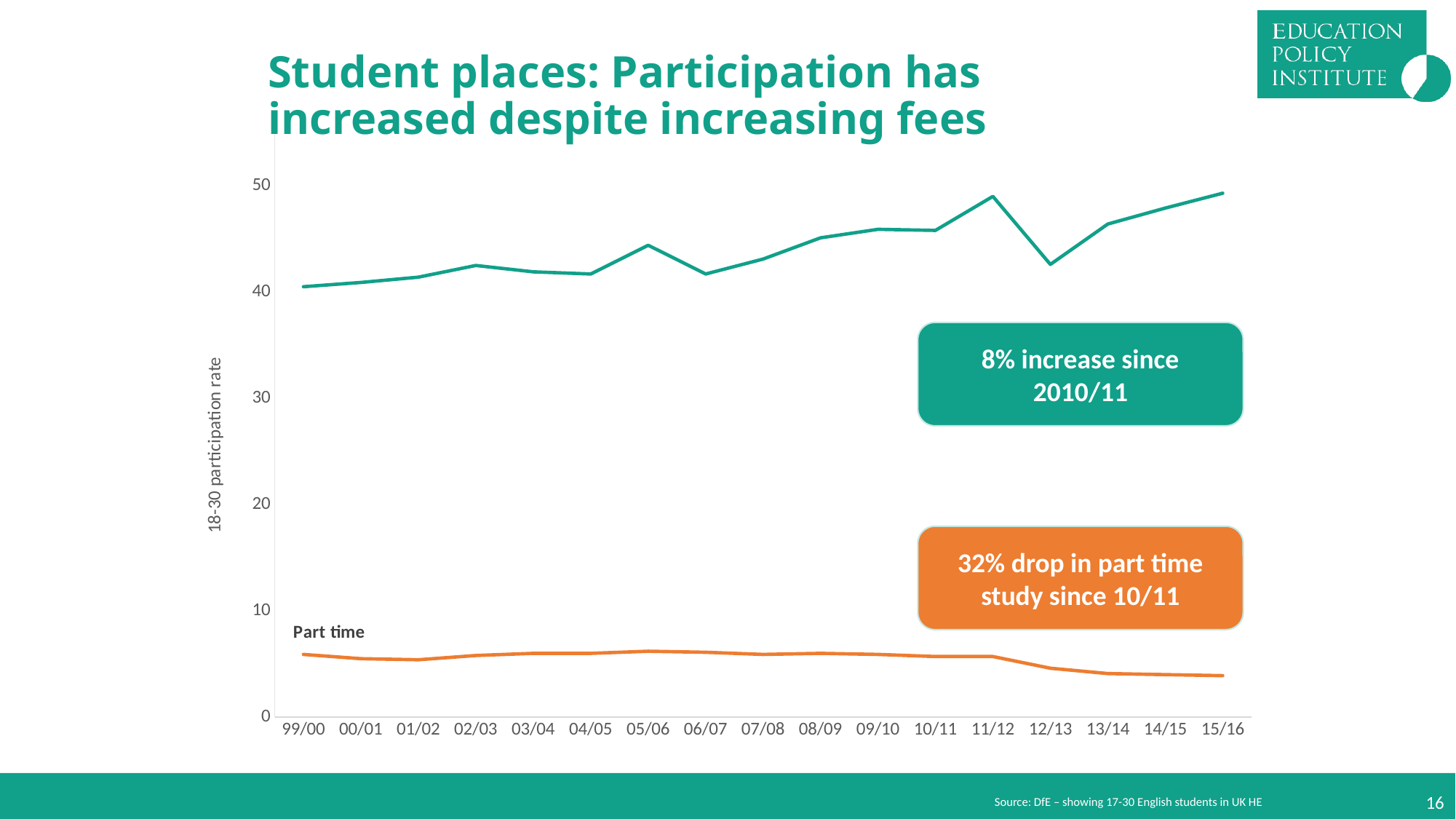
Which is larger for the Part time line: the value in 99/00 or the value in 15/16? 99/00 In which year does the upper (green) line reach its highest point? 15/16 What does the green callout box on the chart say? 8% increase since 2010/11 What kind of chart is shown on the slide? line chart How many academic years are shown along the x axis? 17 Is the value of the upper (green) line in 11/12 greater or less than 50? less Does the Part time line rise or fall between 11/12 and 15/16? fall Is the value of the upper (green) line in 12/13 greater or less than 40? greater Which is larger for the upper (green) line: the value in 99/00 or the value in 15/16? 15/16 What is the label on the vertical axis? 18-30 participation rate Which is larger for the upper (green) line: the value in 11/12 or the value in 12/13? 11/12 Is the Part time value in 15/16 greater or less than 10? less